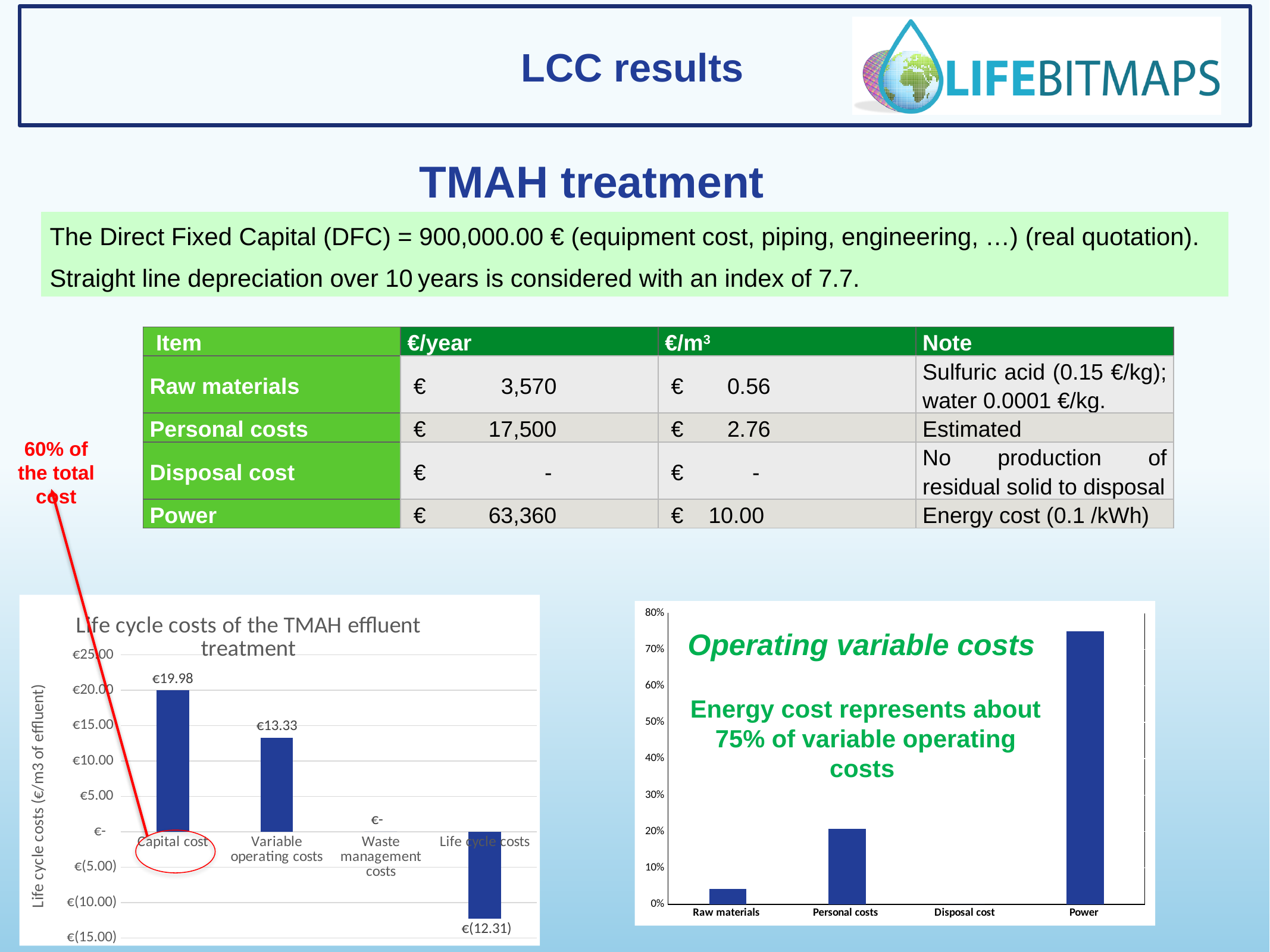
In the 'Life cycle costs of the TMAH effluent treatment' chart, what is the value for Capital cost? €19.98 In the 'Life cycle costs of the TMAH effluent treatment' chart, what is the value for Variable operating costs? €13.33 In the 'Life cycle costs of the TMAH effluent treatment' chart, which category has the highest value? Capital cost In the 'Life cycle costs of the TMAH effluent treatment' chart, how many categories are shown on the x axis? 4 In the 'Operating variable costs' chart on the right, which category has the highest value? Power In the 'Operating variable costs' chart on the right, is the value for Power greater or less than 70%? greater In the 'Operating variable costs' chart on the right, which is larger, Personal costs or Raw materials? Personal costs In the 'Operating variable costs' chart on the right, is the value for Raw materials greater or less than 10%? less In the 'Life cycle costs of the TMAH effluent treatment' chart, what is the value for Waste management costs? €- In the 'Life cycle costs of the TMAH effluent treatment' chart, what is the difference between Capital cost and Variable operating costs? €6.65 What kind of chart is the 'Life cycle costs of the TMAH effluent treatment' chart? Bar chart In the 'Life cycle costs of the TMAH effluent treatment' chart, what is the value for Life cycle costs? €(12.31)